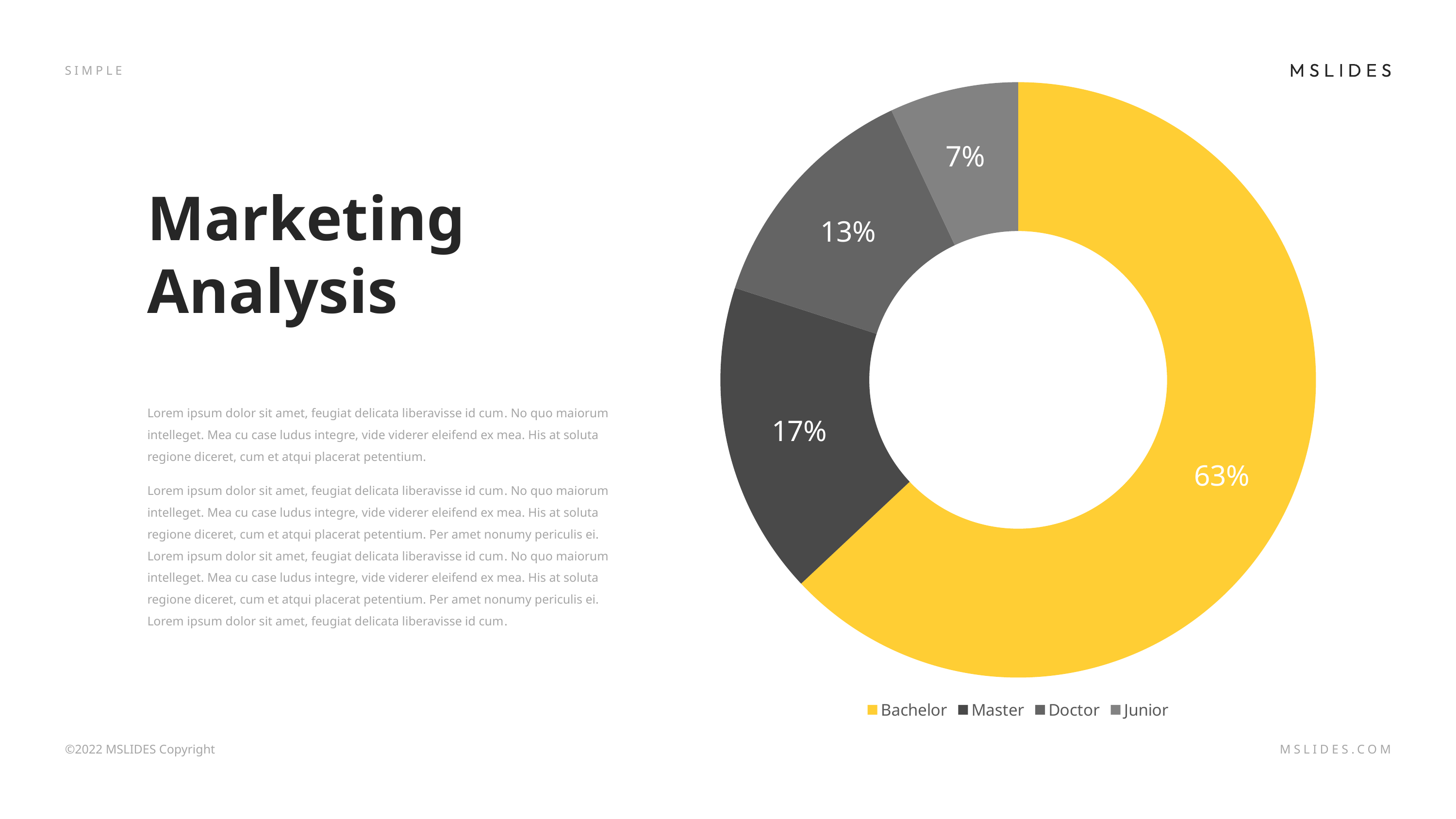
What percentage is shown for Doctor in the chart? 13% What share of the doughnut chart does Bachelor represent? 63% What is the difference in percentage points between Bachelor and Master? 46 What type of chart is shown on the slide? Doughnut chart What percentage is shown for Master in the chart? 17% Which category has the smallest share in the chart? Junior How many categories does the chart show? 4 Which colour represents Bachelor in the chart? Yellow What is the difference in percentage points between Doctor and Junior? 6 Which category has the largest share in the chart? Bachelor What percentage is shown for Junior in the chart? 7% Which has a larger share, Master or Doctor? Master